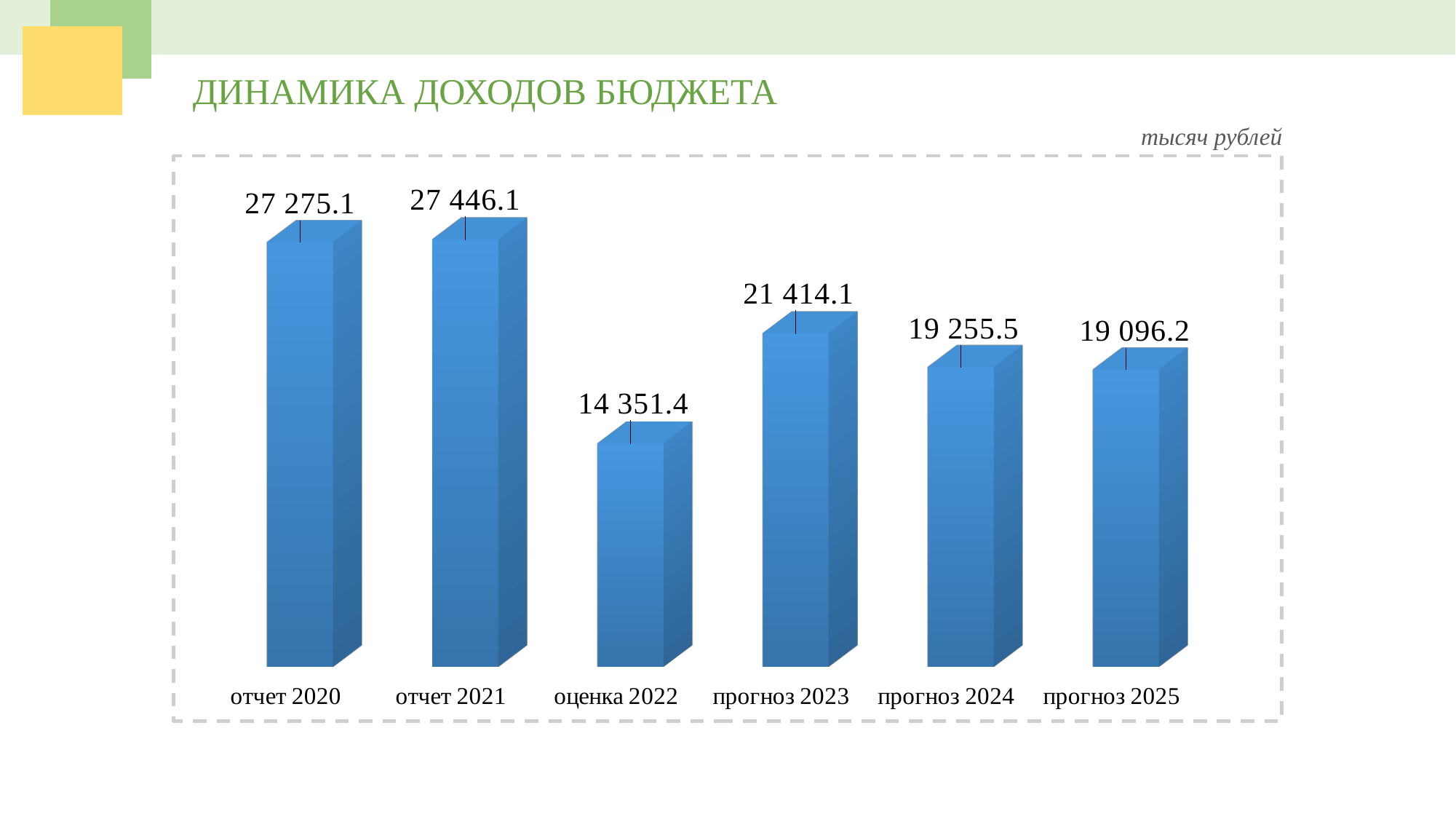
What is the difference between the values for отчет 2021 and отчет 2020? 171.0 Which category has the highest value? отчет 2021 From прогноз 2023 to прогноз 2025, do the values rise or fall? fall Which category has the lowest value? оценка 2022 What is the value for прогноз 2024? 19 255.5 What is the value for оценка 2022? 14 351.4 What is the difference between the values for прогноз 2023 and оценка 2022? 7 062.7 What kind of chart is shown on the slide? bar chart How many categories are shown in the chart? 6 What unit is indicated for the chart values? тысяч рублей Which is larger, the value for прогноз 2023 or the value for прогноз 2024? прогноз 2023 What is the value for отчет 2020? 27 275.1